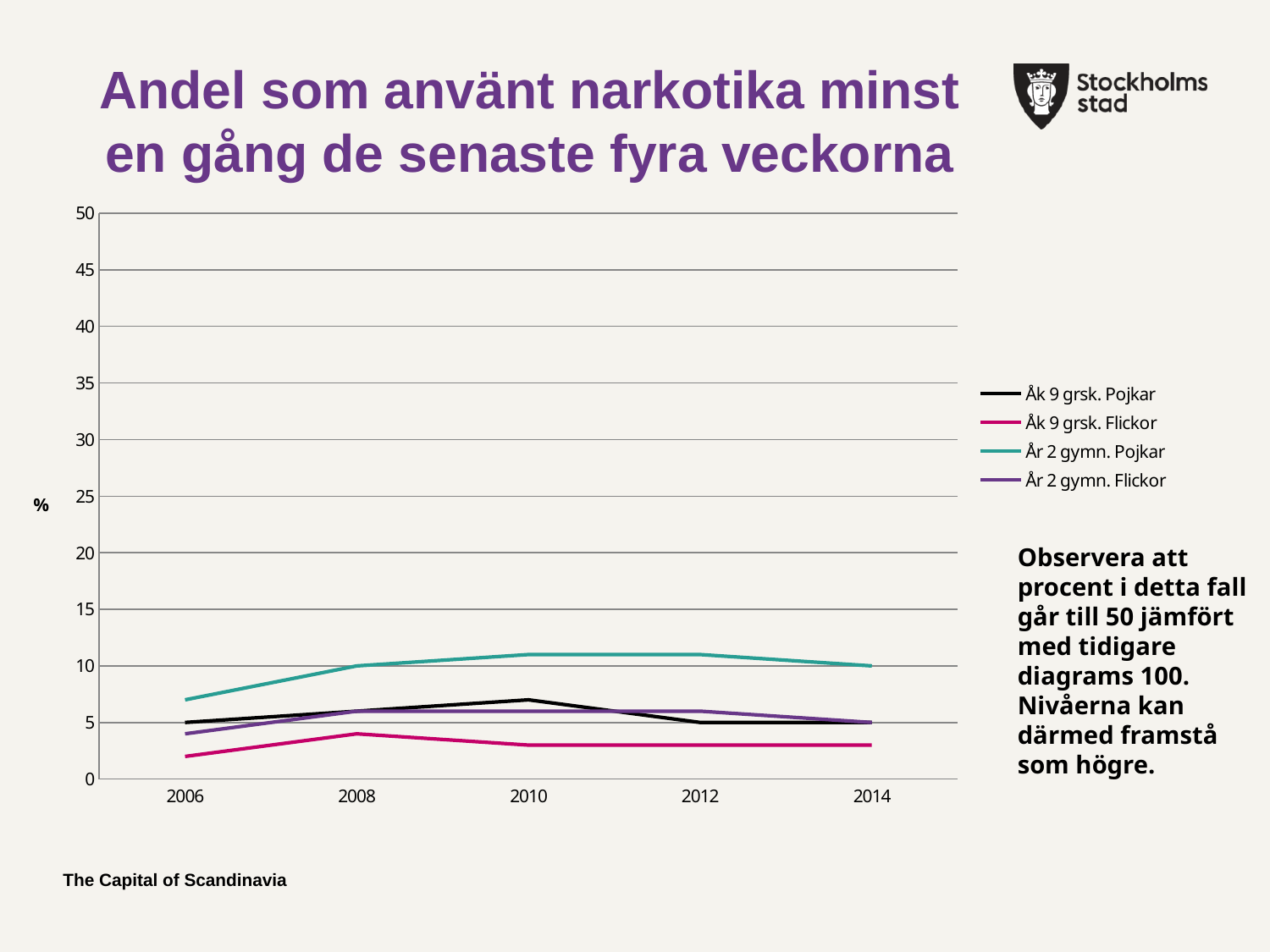
What is the value for År 2 gymn. Pojkar in 2008? 10 How many years are shown on the x axis? 5 What is the highest value shown on the y axis? 50 Which is larger in 2006, the value for År 2 gymn. Pojkar or the value for Åk 9 grsk. Pojkar? År 2 gymn. Pojkar How many series does the legend list? 4 Is the value for År 2 gymn. Pojkar in 2010 greater or less than 15? less Is the value for Åk 9 grsk. Flickor in 2006 greater or less than 5? less What is the value for Åk 9 grsk. Pojkar in 2006? 5 Which series has the lowest value in 2006? Åk 9 grsk. Flickor Which series has the highest value in 2014? År 2 gymn. Pojkar Does the value for År 2 gymn. Pojkar rise or fall from 2006 to 2010? rise What kind of chart is shown on the slide? line chart